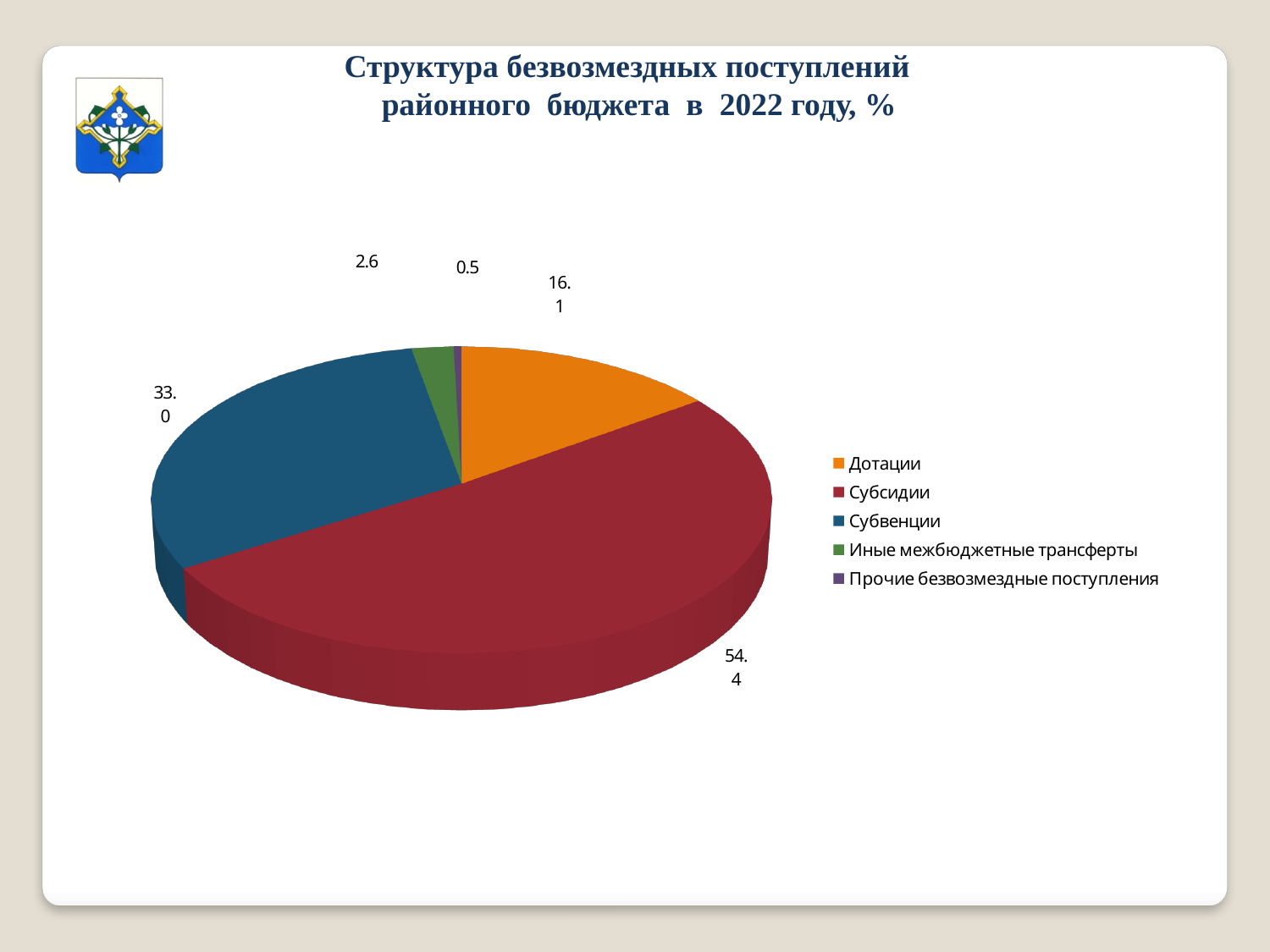
Which category has the largest share of the pie? Субсидии What is the value for Прочие безвозмездные поступления? 0.5 Which category has the smallest share of the pie? Прочие безвозмездные поступления What is the value for Субсидии? 54.4 What is the value for Дотации? 16.1 Which is larger, the value for Дотации or the value for Субвенции? Субвенции What is the value for Субвенции? 33.0 What is the value for Иные межбюджетные трансферты? 2.6 What kind of chart is shown on the slide? Pie chart What is the difference between the values for Субсидии and Субвенции? 21.4 How many categories does the pie chart show? 5 What is the title of the chart? Структура безвозмездных поступлений районного бюджета в 2022 году, %